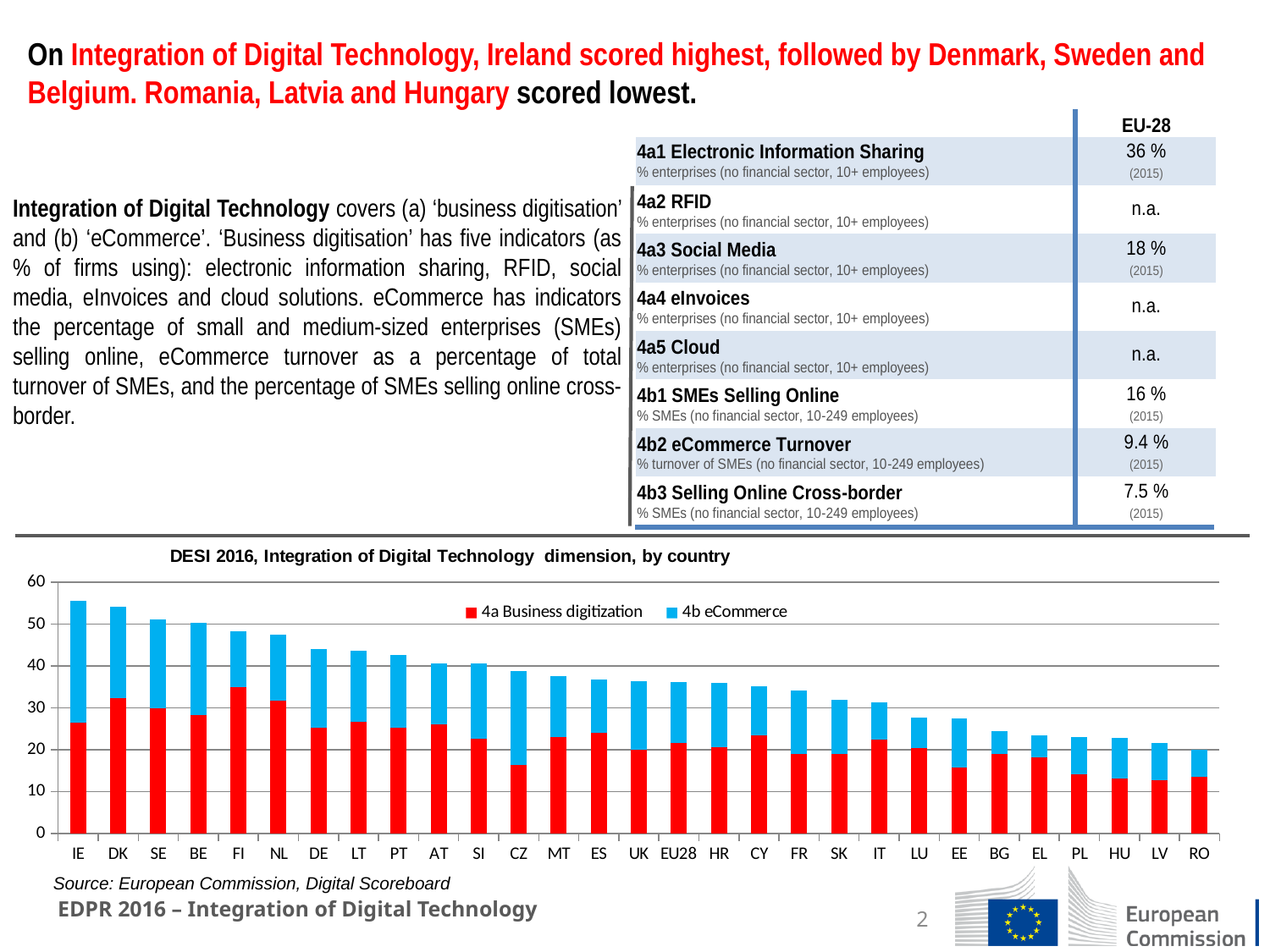
Which country has the larger 4a Business digitization value, FI or CZ? FI Is the total value for RO greater or less than 30? less Which series is shown in red in the chart? 4a Business digitization How many countries/categories are shown along the x axis of the chart? 29 Is the total value for IE greater or less than 50? greater What kind of chart is shown at the bottom of the slide? Stacked bar chart Which country has the highest total bar in the chart? IE Do the total bar heights rise or fall moving from left to right along the x axis? Fall Which country has the lowest total bar in the chart? RO Is the 4a Business digitization value for CZ greater or less than 20? less How many series does the chart's legend list? 2 What is the title of the chart on the slide? DESI 2016, Integration of Digital Technology dimension, by country